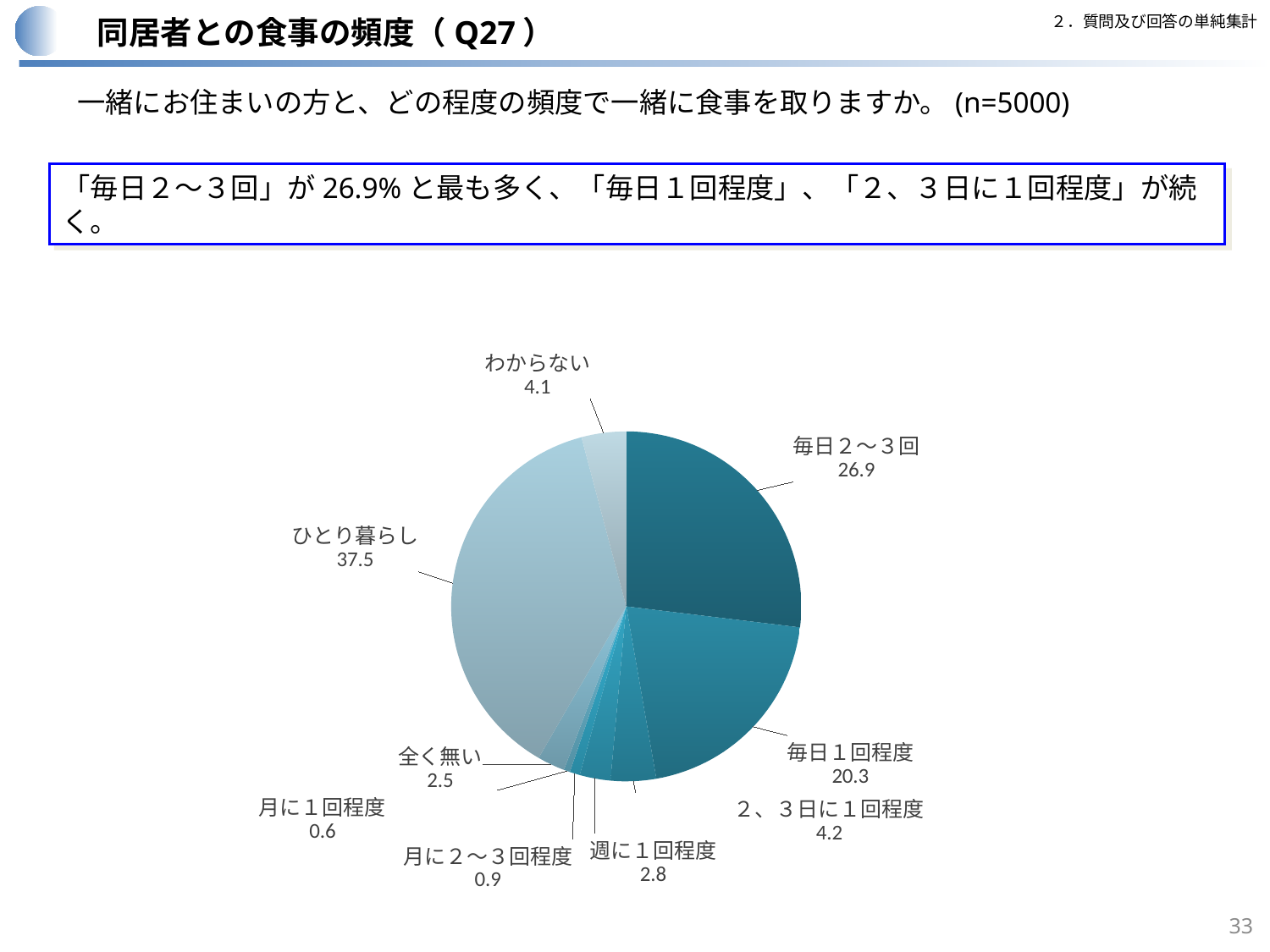
What is the sample size (n) stated on the slide? 5000 Which category has the largest slice in the pie chart? ひとり暮らし What value is shown for 週に１回程度 in the pie chart? 2.8 Which is larger, the value for ２、３日に１回程度 or the value for わからない? ２、３日に１回程度 What value is shown for 月に１回程度 in the pie chart? 0.6 How many categories are shown in the pie chart? 9 What is the difference between the values for 毎日２～３回 and 毎日１回程度? 6.6 What value is shown for 毎日２～３回 in the pie chart? 26.9 Which is larger, the value for 全く無い or the value for 月に２～３回程度? 全く無い What value is shown for ひとり暮らし in the pie chart? 37.5 What kind of chart is shown on the slide? Pie chart Which category has the smallest slice in the pie chart? 月に１回程度